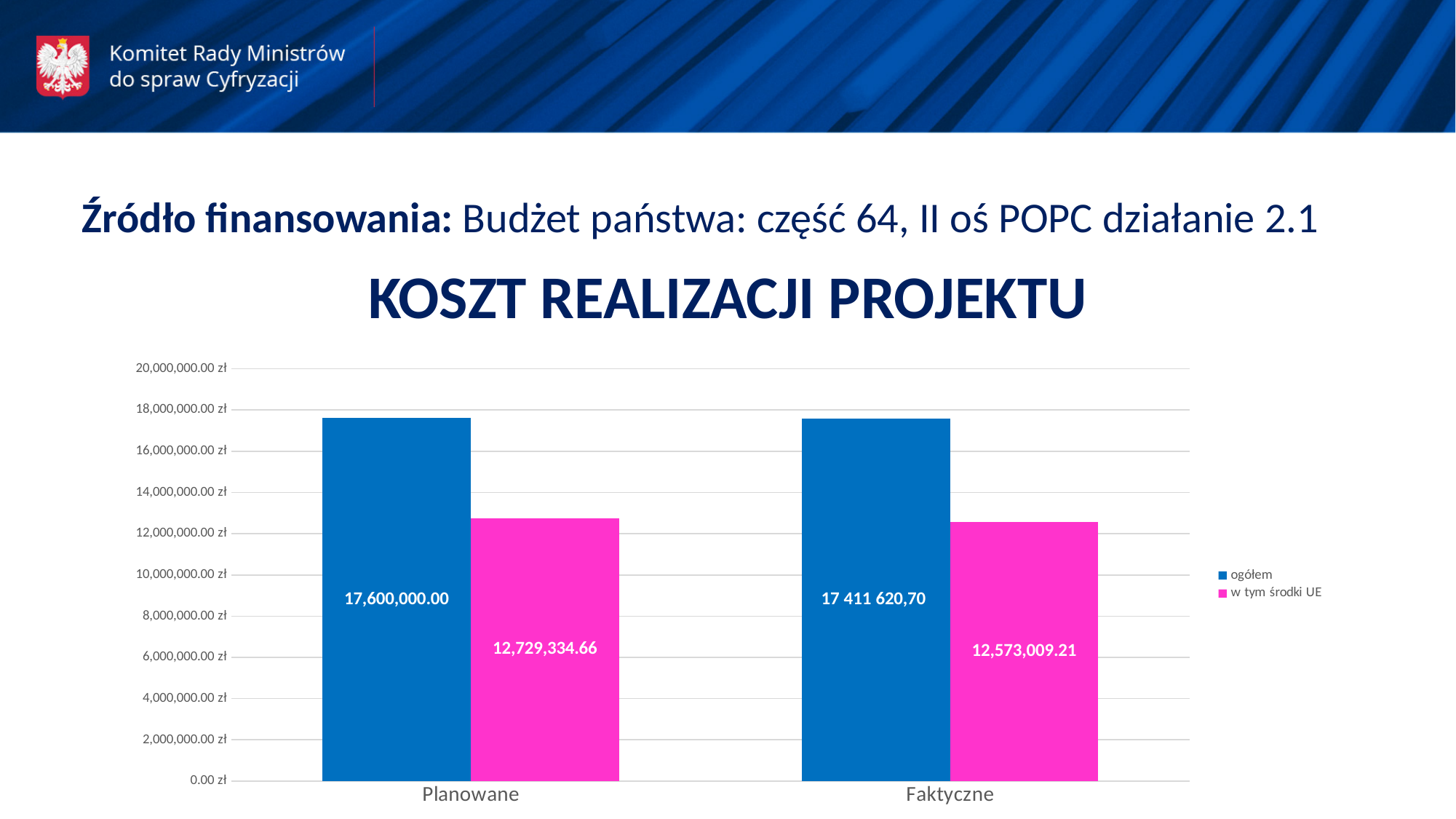
What kind of chart is shown on the slide? bar chart What is the value of the w tym środki UE bar for Planowane? 12,729,334.66 What is the value of the ogółem bar for Planowane? 17,600,000.00 What is the value of the w tym środki UE bar for Faktyczne? 12,573,009.21 What is the title of the chart? KOSZT REALIZACJI PROJEKTU Is the w tym środki UE value for Faktyczne greater or less than 14,000,000.00 zł? less Which category has the higher ogółem value, Planowane or Faktyczne? Planowane How many series does the legend list? 2 What is the value of the ogółem bar for Faktyczne? 17 411 620,70 How many categories are shown on the x axis? 2 What is the difference between the ogółem and w tym środki UE values for Planowane? 4,870,665.34 What is the difference between the ogółem values for Planowane and Faktyczne? 188,379.30